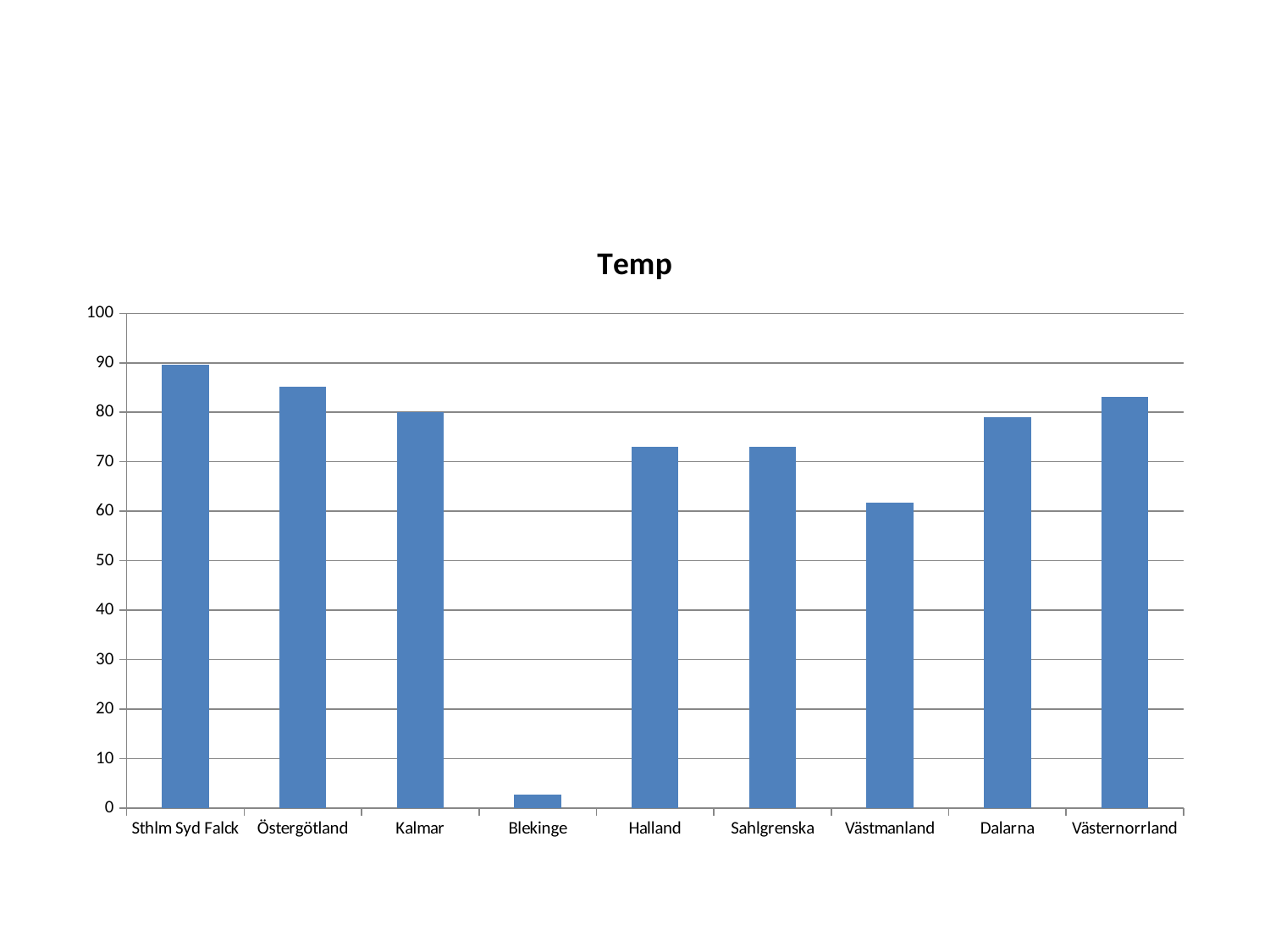
Which category has the lowest value in the chart? Blekinge Is the value for Östergötland greater or less than 90? less Is the value for Blekinge greater or less than 10? less Which has a larger value, Östergötland or Halland? Östergötland How many categories are shown on the x axis of the chart? 9 Is the value for Sthlm Syd Falck greater or less than 80? greater Which has a larger value, Västmanland or Dalarna? Dalarna What type of chart is shown on the slide? bar chart Which category has the highest value in the chart? Sthlm Syd Falck What is the title of the chart? Temp